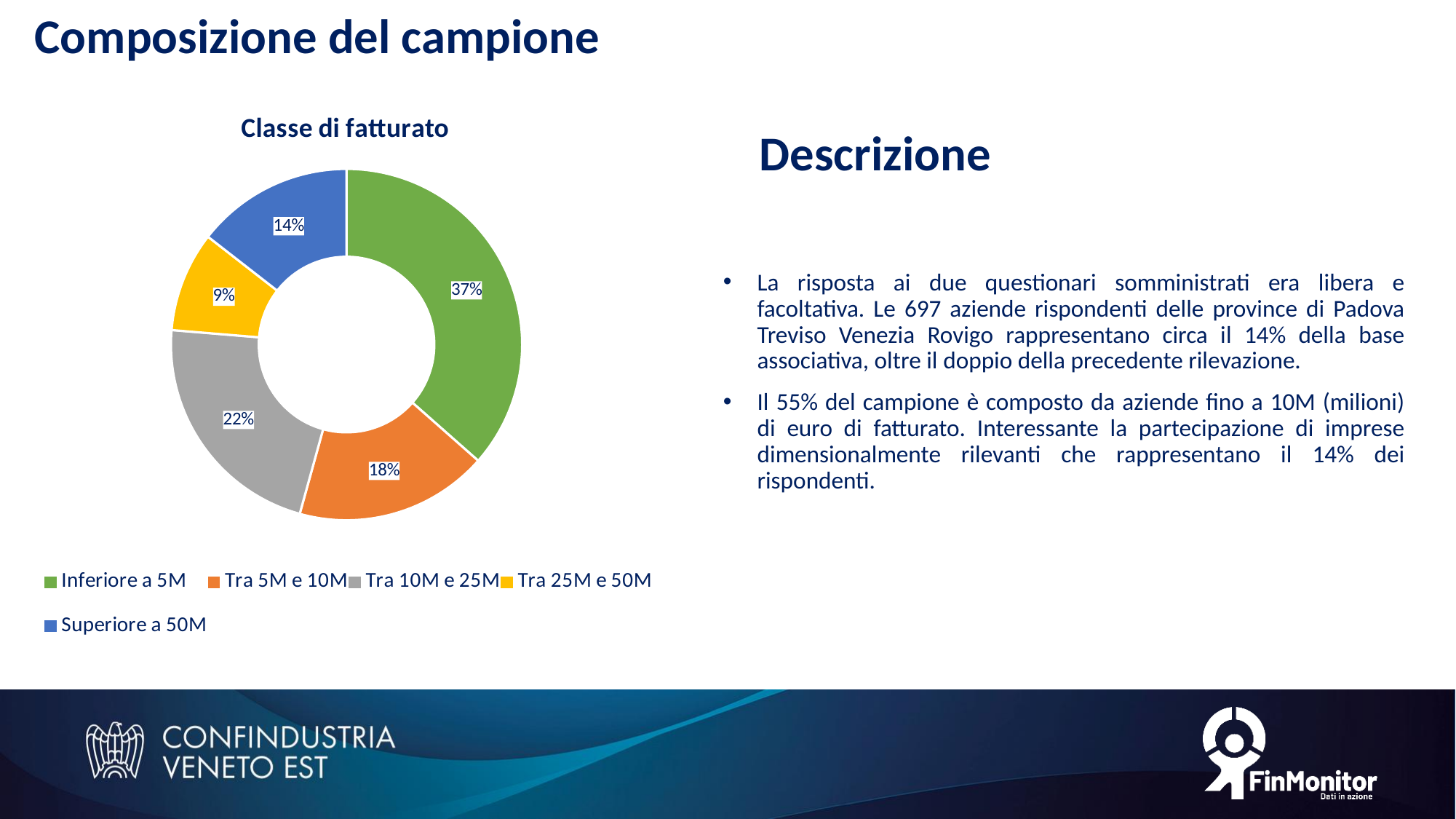
Which revenue class has the largest share in the 'Classe di fatturato' chart? Inferiore a 5M What share of the sample does the 'Inferiore a 5M' slice represent in the 'Classe di fatturato' chart? 37% In the 'Classe di fatturato' chart, which is larger: 'Tra 5M e 10M' or 'Superiore a 50M'? Tra 5M e 10M What type of chart is 'Classe di fatturato'? Doughnut (pie) chart What colour represents 'Tra 10M e 25M' in the 'Classe di fatturato' chart? Grey What percentage is shown for 'Tra 25M e 50M' in the 'Classe di fatturato' chart? 9% How many revenue classes are shown in the 'Classe di fatturato' chart? 5 What percentage is shown for 'Superiore a 50M' in the 'Classe di fatturato' chart? 14% What percentage is shown for 'Tra 10M e 25M' in the 'Classe di fatturato' chart? 22% In the 'Classe di fatturato' chart, what is the difference in percentage points between 'Inferiore a 5M' and 'Tra 10M e 25M'? 15 Which revenue class has the smallest share in the 'Classe di fatturato' chart? Tra 25M e 50M What percentage is shown for 'Tra 5M e 10M' in the 'Classe di fatturato' chart? 18%